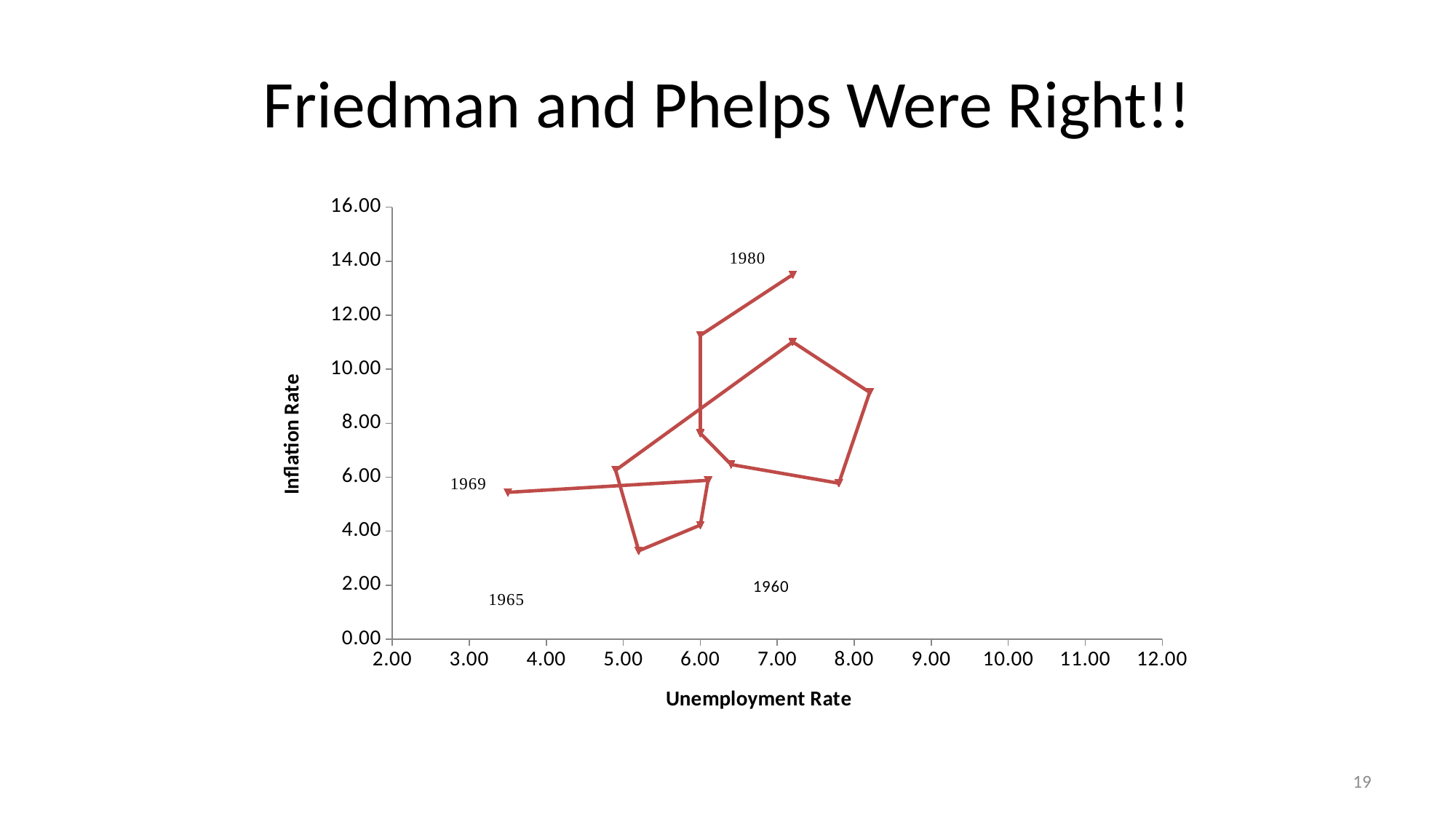
Which labelled year has the highest inflation rate on the chart? 1980 Is the inflation rate for the point labelled 1980 greater or less than 12.00? greater What kind of chart is shown on the slide? Scatter chart with points connected by lines Is the unemployment rate for the point labelled 1980 greater or less than 8.00? less What is the maximum value shown on the Inflation Rate axis? 16.00 What are the x-axis and y-axis titles of the chart? Unemployment Rate (x-axis) and Inflation Rate (y-axis) Is the unemployment rate for the point labelled 1969 greater or less than 4.00? less What is the title of the slide containing the chart? Friedman and Phelps Were Right!! Which has the higher inflation rate, the point labelled 1980 or the point labelled 1969? 1980 Which labelled point has the lowest unemployment rate on the chart? 1969 What is the maximum value shown on the Unemployment Rate axis? 12.00